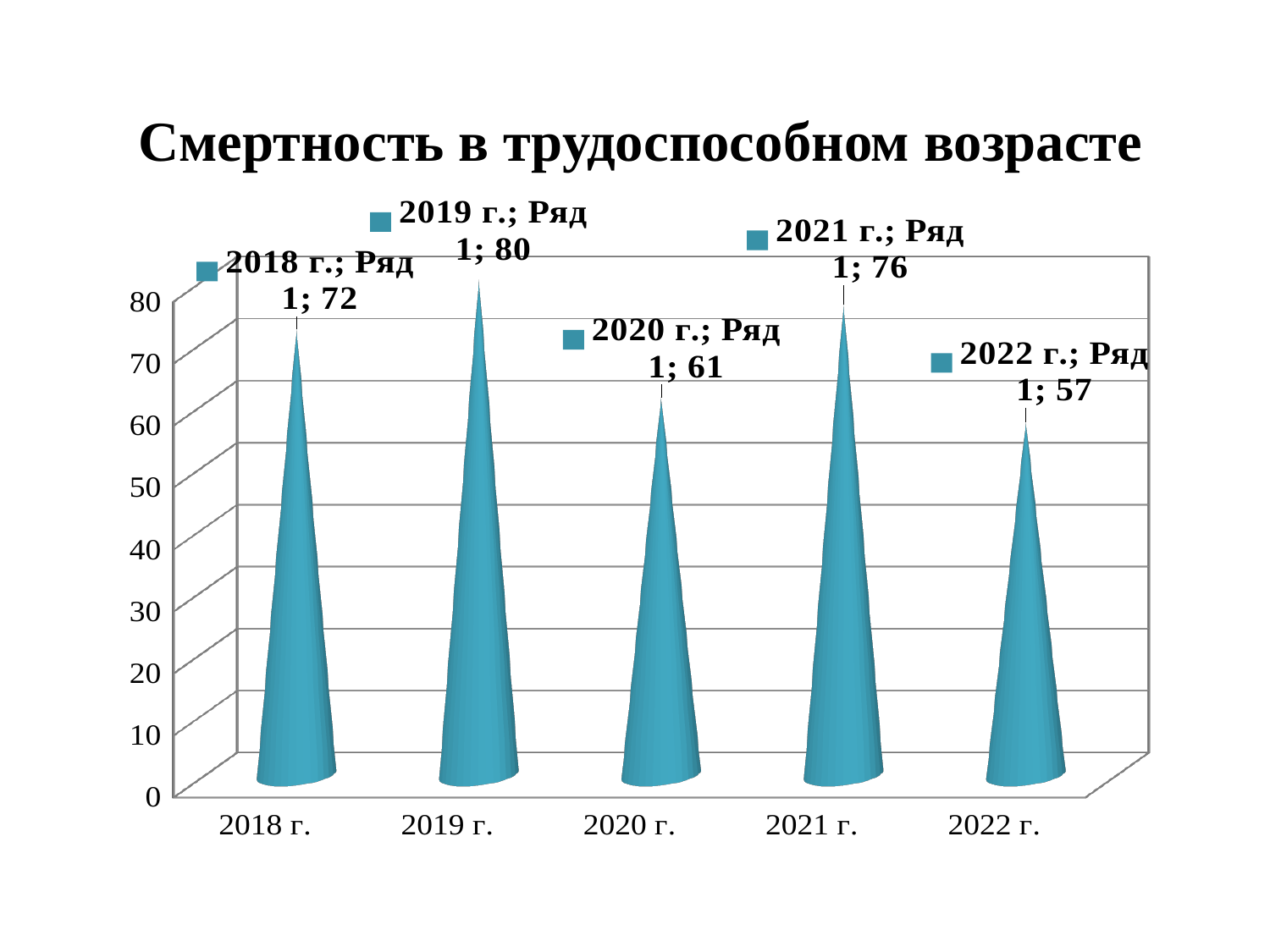
What is the value for 2018 г.? 72 Which year has the lowest value? 2022 г. What is the value for 2020 г.? 61 What is the difference between the values for 2021 г. and 2020 г.? 15 How many years are shown on the x axis? 5 Which year has the highest value? 2019 г. What is the difference between the values for 2019 г. and 2022 г.? 23 What kind of chart is this? bar chart Which is larger, the value for 2018 г. or the value for 2021 г.? 2021 г. What is the title of the chart? Смертность в трудоспособном возрасте What is the value for 2022 г.? 57 Do the values rise or fall from 2021 г. to 2022 г.? fall